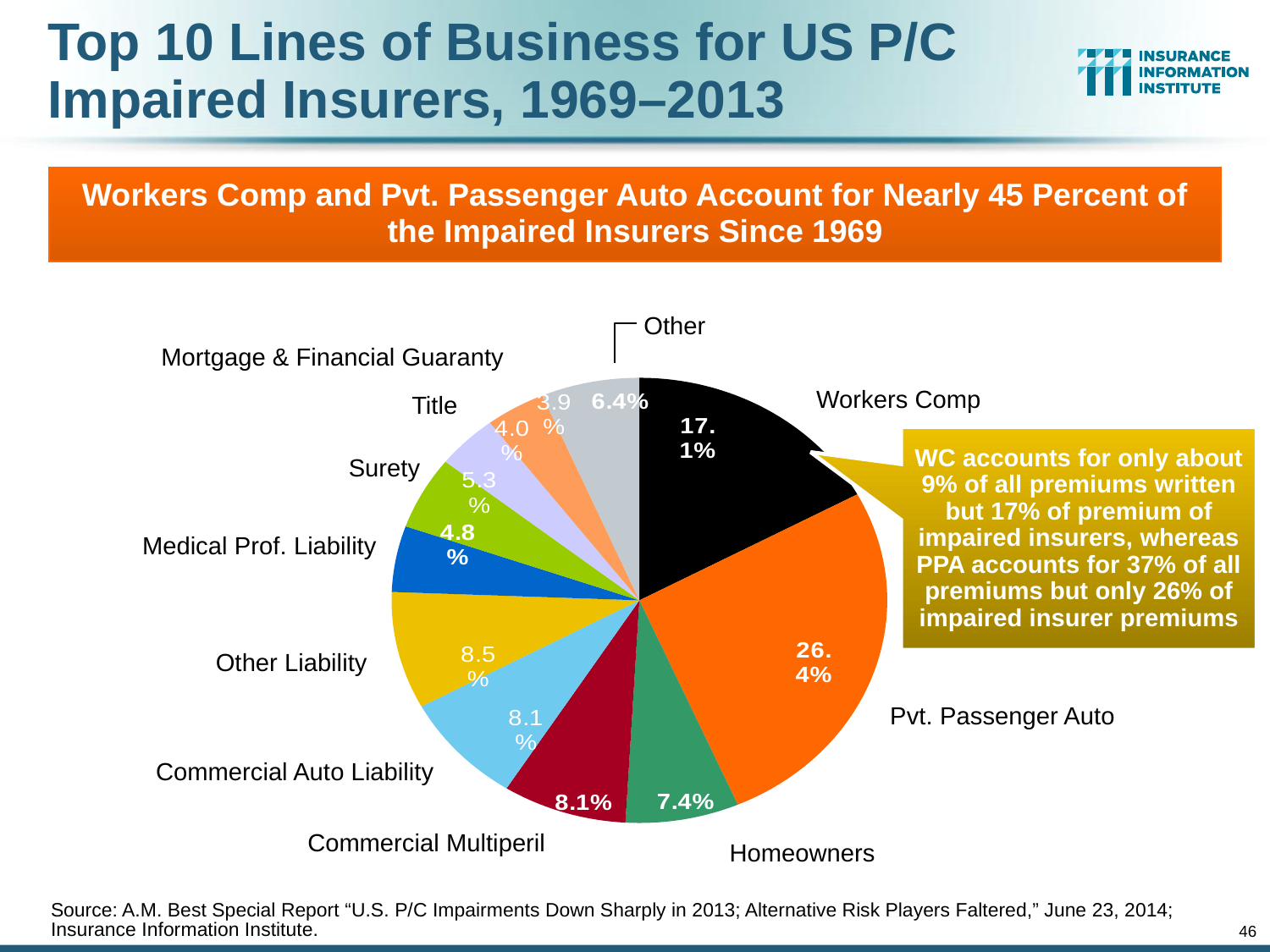
What percentage is shown for Other Liability? 8.5% What is the difference in percentage points between Pvt. Passenger Auto and Workers Comp? 9.3 What share of impaired insurers is attributed to Pvt. Passenger Auto? 26.4% What percentage is shown for Homeowners? 7.4% How many slices does the pie chart have? 11 What type of chart is shown on the slide? Pie chart Which line of business has the largest slice of the pie? Pvt. Passenger Auto Which line of business has the smallest slice of the pie? Mortgage & Financial Guaranty What is the combined share of Workers Comp and Pvt. Passenger Auto? 43.5% Which is larger, the share for Surety or the share for Medical Prof. Liability? Surety What share of impaired insurers is attributed to Workers Comp? 17.1% What percentage is shown for Mortgage & Financial Guaranty? 3.9%